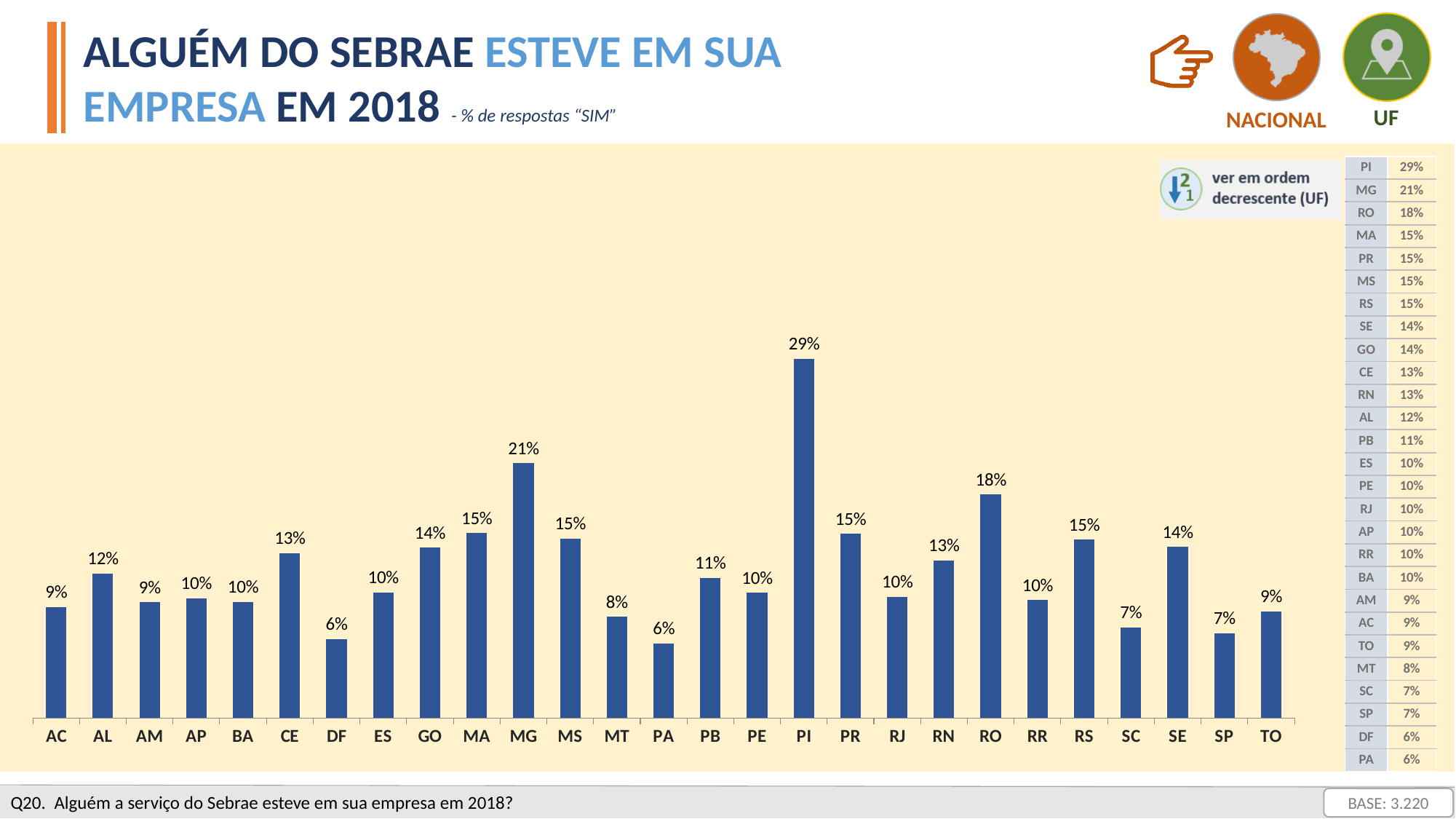
What is the value for PI? 29% How many states (categories) are shown on the x axis? 27 Which state has the highest value? PI What is the difference between the values for RO and TO? 9% What is the value for SC? 7% What is the base (sample size) shown on the slide? 3.220 What kind of chart is shown on the slide? bar chart What is the difference between the values for PI and MG? 8% Which is larger, the value for CE or the value for PB? CE Which is larger, the value for SE or the value for MT? SE What is the value for MG? 21% What is the value for RO? 18%